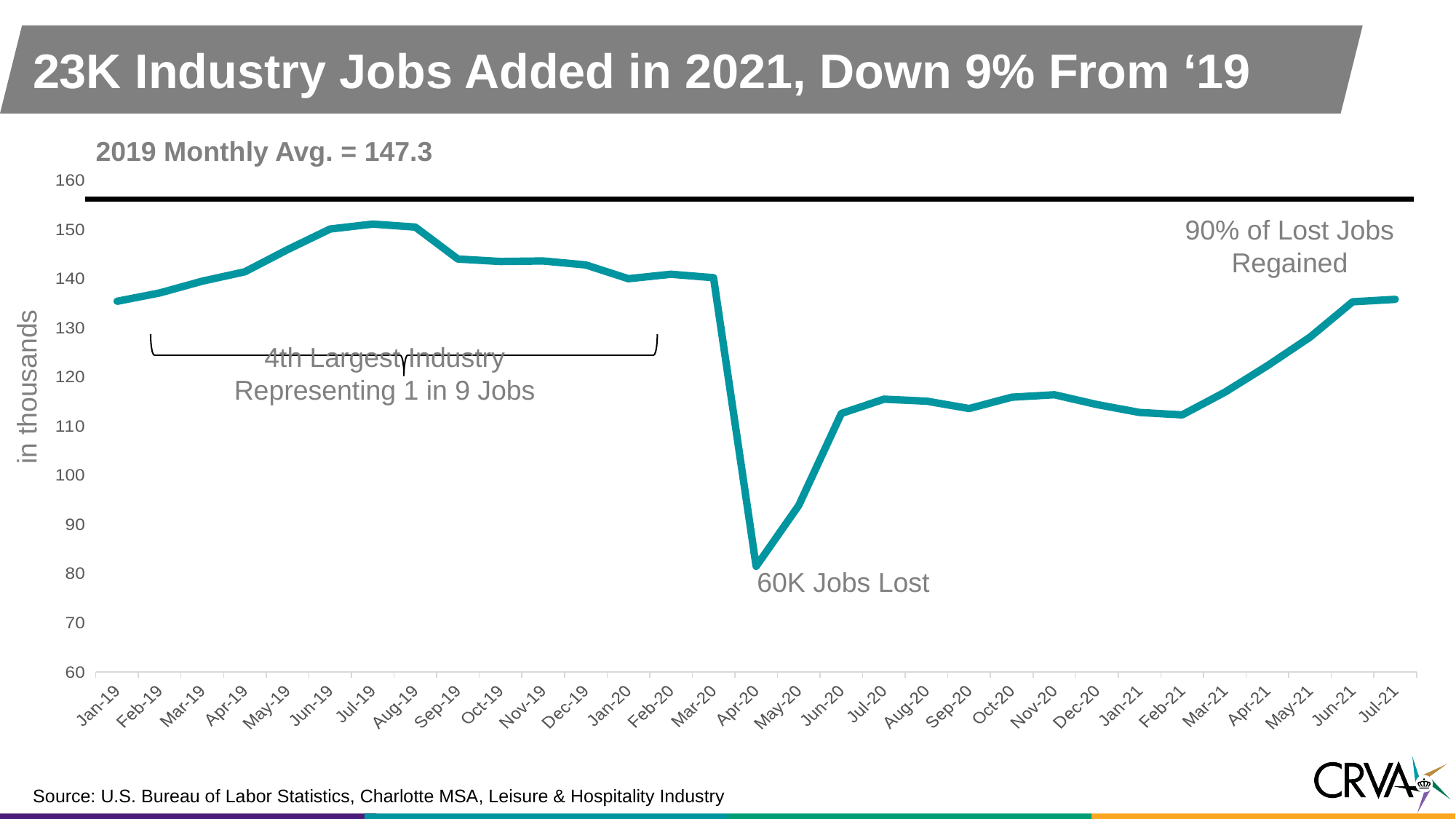
How many monthly data points are plotted on the chart, from Jan-19 to Jul-21? 31 Is the value for Jul-19 greater or less than 140? greater What kind of chart is shown on the slide? line chart Do the values rise or fall from Feb-21 to Jul-21? rise Which is larger, the value for Jul-20 or the value for Jul-21? Jul-21 Is the value for Jan-19 greater or less than 130? greater What is the label on the vertical axis of the chart? in thousands What is the 2019 monthly average stated on the chart? 147.3 Is the value for Feb-21 greater or less than 120? less Which is larger, the value for Mar-20 or the value for Apr-20? Mar-20 Which month has the lowest value on the chart? Apr-20